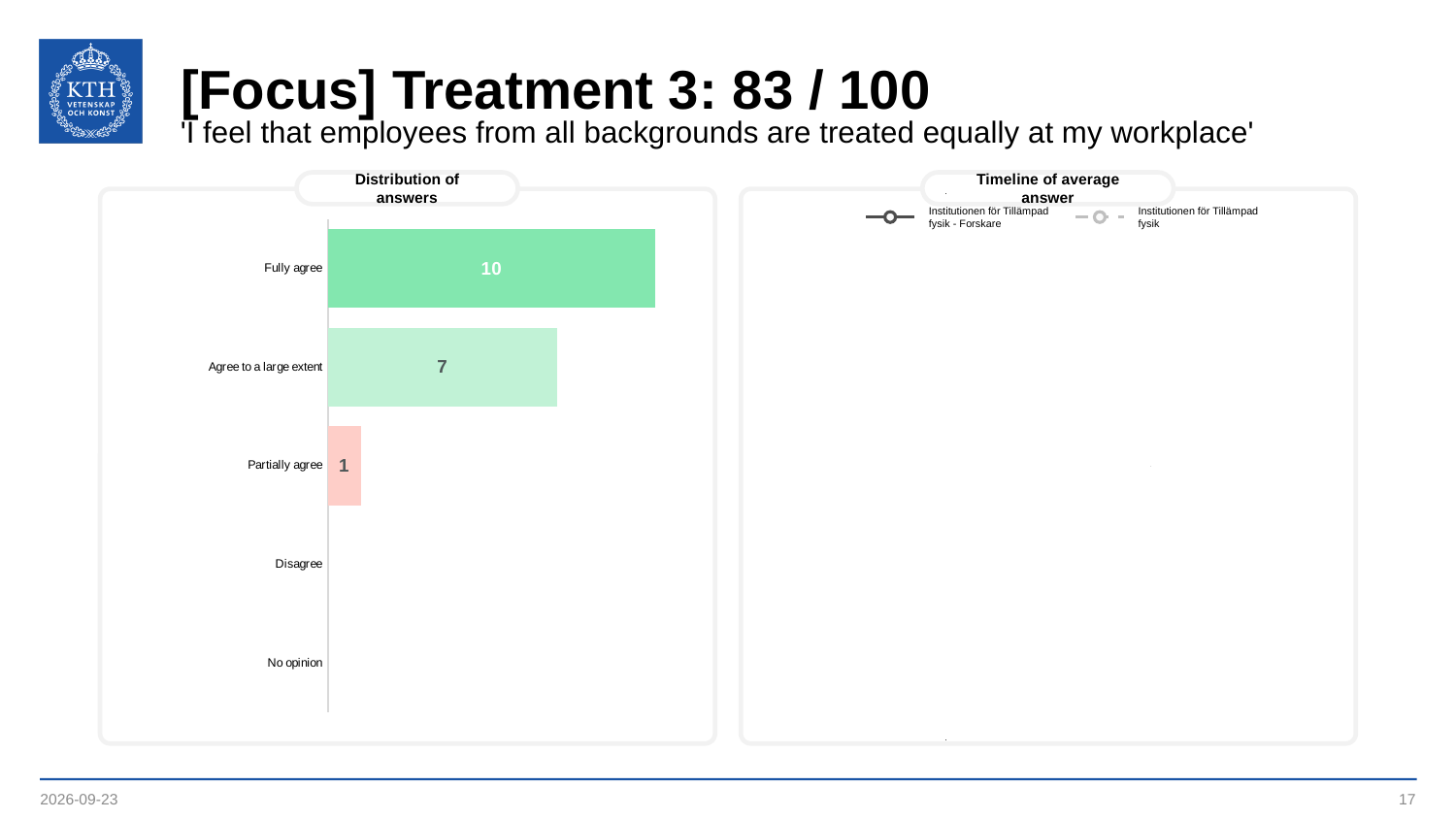
In the 'Distribution of answers' chart, what is the difference between Agree to a large extent and Partially agree? 6 How many categories are listed on the axis of the 'Distribution of answers' chart? 5 In the 'Distribution of answers' chart, what is the difference between Fully agree and Agree to a large extent? 3 What is the title of the chart on the left side of the slide? Distribution of answers In the 'Distribution of answers' chart, what is the value for Fully agree? 10 In the 'Distribution of answers' chart, which category has the highest value? Fully agree In the 'Distribution of answers' chart, which is larger: Fully agree or Partially agree? Fully agree In the 'Distribution of answers' chart, what is the value for Agree to a large extent? 7 In the 'Distribution of answers' chart, what is the value for Partially agree? 1 How many series does the legend of the 'Timeline of average answer' chart list? 2 In the 'Distribution of answers' chart, what colour is the Partially agree bar? Light red What kind of chart is the 'Distribution of answers' chart? Bar chart